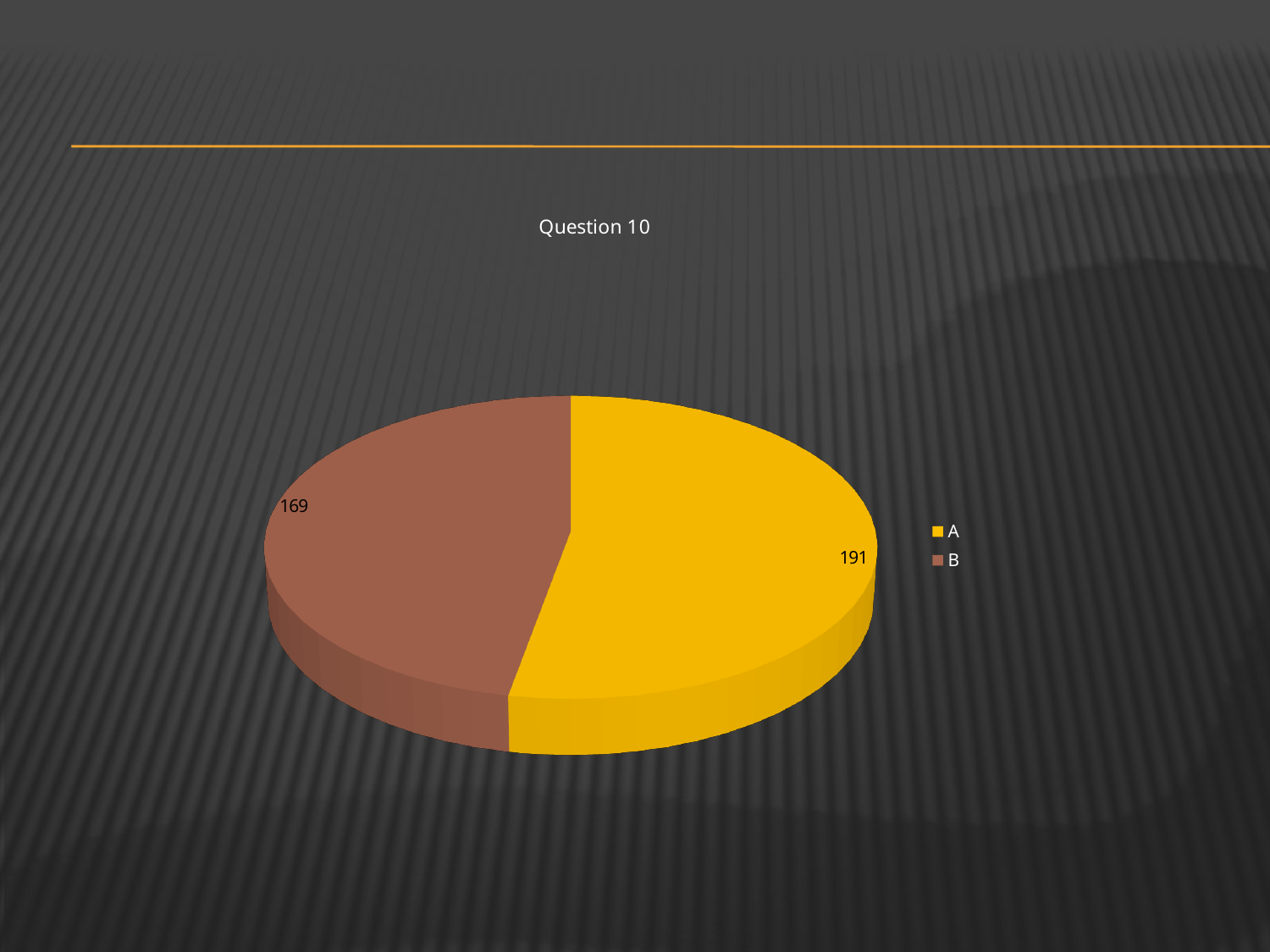
What is the value for A? 191 What is the difference between the values for A and B? 22 What colour is the slice for A? Yellow How many slices does the pie chart have? 2 What kind of chart is shown on the slide? Pie chart What is the title of the chart? Question 10 What is the total of all slices in the pie chart? 360 Which category has the largest slice? A What is the value for B? 169 Which is larger, the value for A or the value for B? A Which category has the smallest slice? B